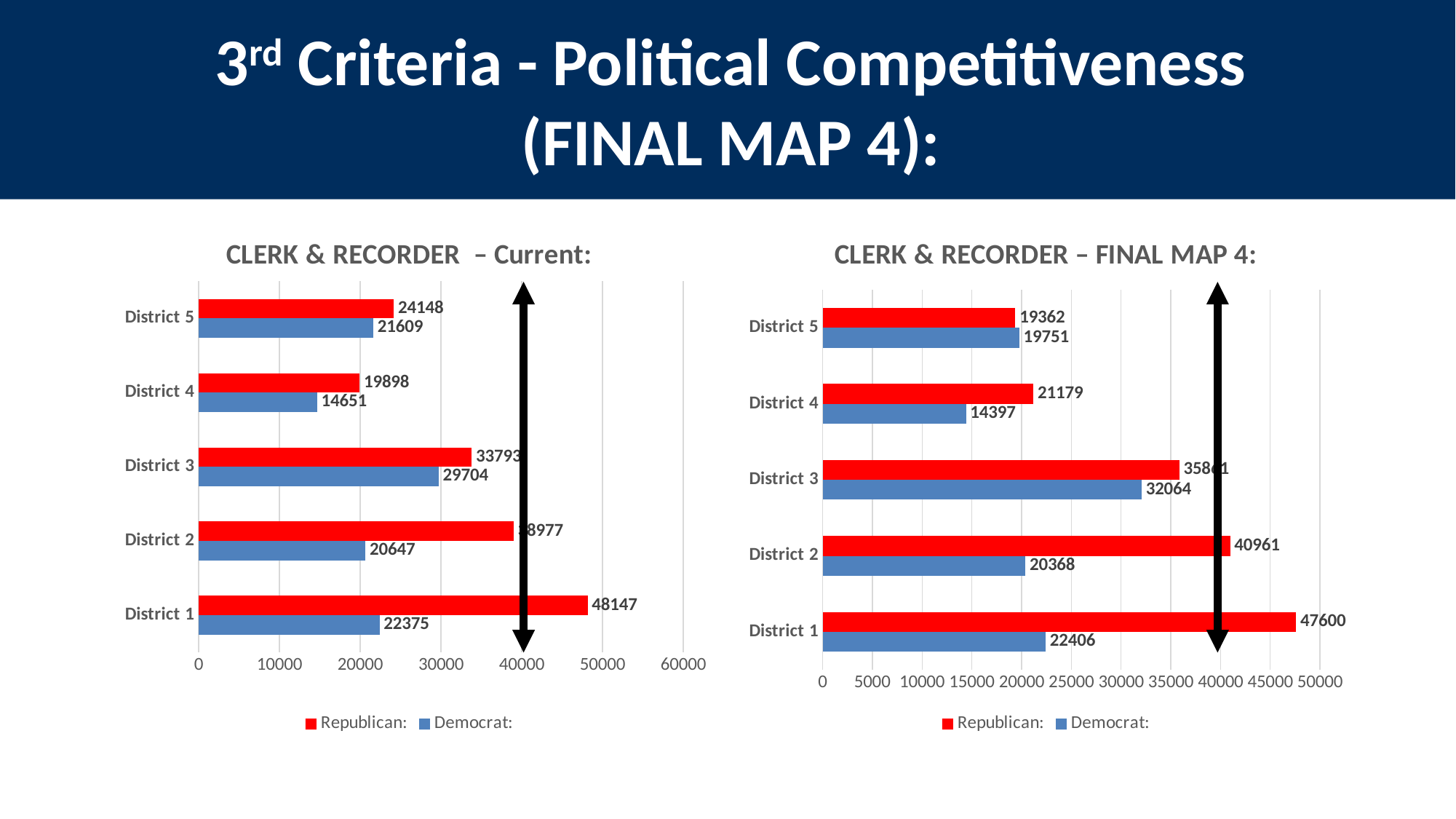
In the CLERK & RECORDER – Current chart, what is the difference between the Republican and Democrat values for District 5? 2539 In the CLERK & RECORDER – Current chart, what is the Democrat value for District 4? 14651 In the CLERK & RECORDER – Current chart, what is the Republican value for District 1? 48147 In the CLERK & RECORDER – FINAL MAP 4 chart, is the Republican or Democrat value larger for District 5? Democrat In the CLERK & RECORDER – Current chart, which district has the highest Republican value? District 1 In the CLERK & RECORDER – FINAL MAP 4 chart, what is the Democrat value for District 5? 19751 In the CLERK & RECORDER – FINAL MAP 4 chart, what is the difference between the Republican and Democrat values for District 1? 25194 In the CLERK & RECORDER – FINAL MAP 4 chart, what is the Republican value for District 2? 40961 What type of chart is the CLERK & RECORDER – Current chart? Bar chart How many districts are shown in the CLERK & RECORDER – FINAL MAP 4 chart? 5 In the CLERK & RECORDER – FINAL MAP 4 chart, which district has the lowest Democrat value? District 4 In the CLERK & RECORDER – Current chart, is the Democrat value for District 3 greater or less than 20000? greater